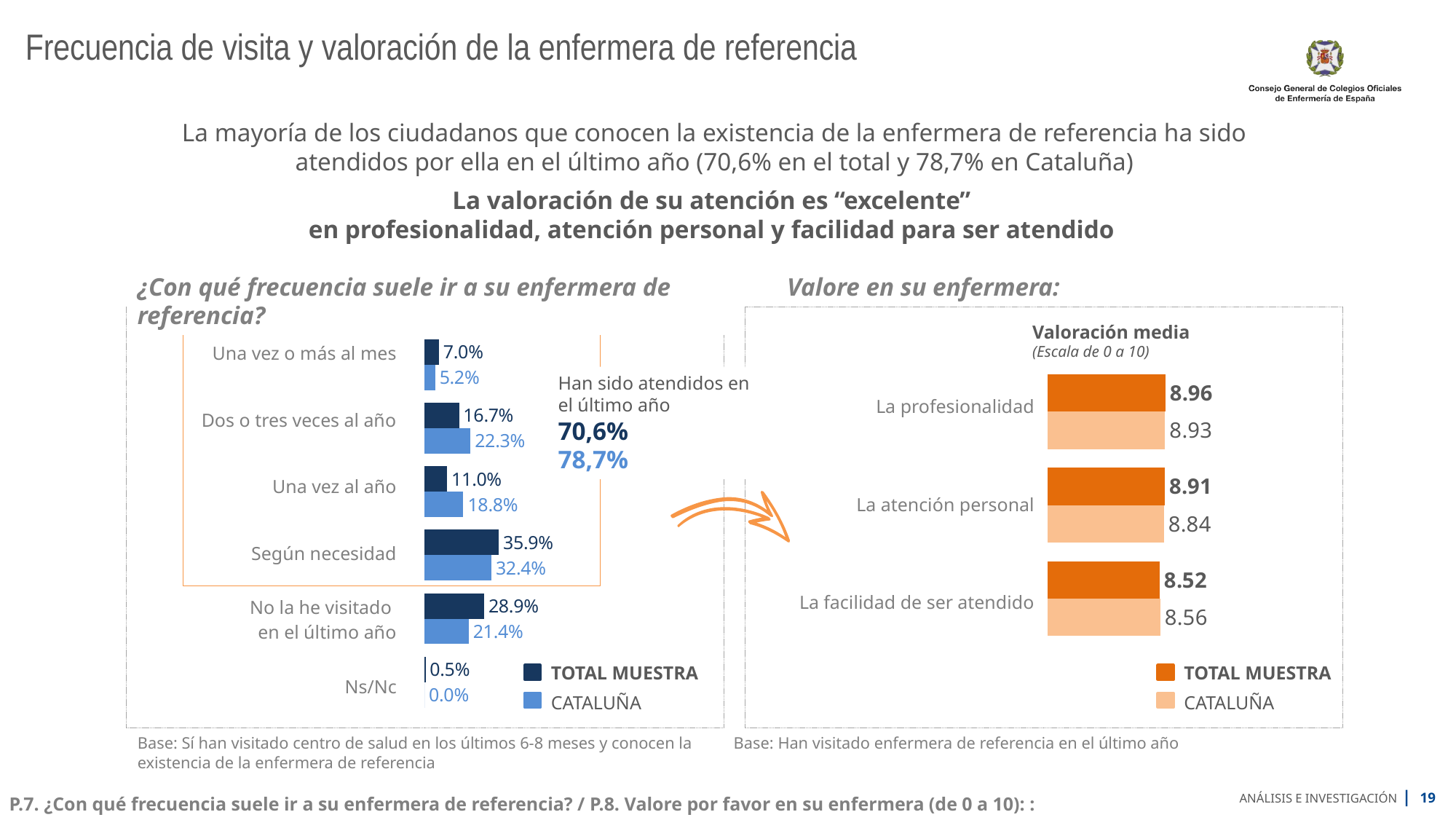
In the left chart (¿Con qué frecuencia suele ir a su enfermera de referencia?), which is larger for 'No la he visitado en el último año': TOTAL MUESTRA or CATALUÑA? TOTAL MUESTRA In the right chart (Valore en su enfermera), what is the TOTAL MUESTRA score for 'La profesionalidad'? 8.96 What type of chart is the right chart (Valore en su enfermera)? Bar chart In the left chart (¿Con qué frecuencia suele ir a su enfermera de referencia?), which category has the lowest CATALUÑA value? Ns/Nc In the left chart (¿Con qué frecuencia suele ir a su enfermera de referencia?), what is the difference between the TOTAL MUESTRA and CATALUÑA values for 'Una vez al año'? 7.8% In the left chart (¿Con qué frecuencia suele ir a su enfermera de referencia?), what is the TOTAL MUESTRA value for 'Según necesidad'? 35.9% In the left chart (¿Con qué frecuencia suele ir a su enfermera de referencia?), what is the CATALUÑA value for 'Dos o tres veces al año'? 22.3% In the left chart (¿Con qué frecuencia suele ir a su enfermera de referencia?), which category has the highest TOTAL MUESTRA value? Según necesidad In the right chart (Valore en su enfermera), what is the CATALUÑA score for 'La facilidad de ser atendido'? 8.56 How many series does the legend of the right chart (Valore en su enfermera) list? 2 How many categories does the left chart (¿Con qué frecuencia suele ir a su enfermera de referencia?) show? 6 In the right chart (Valore en su enfermera), which aspect has the lowest TOTAL MUESTRA score? La facilidad de ser atendido